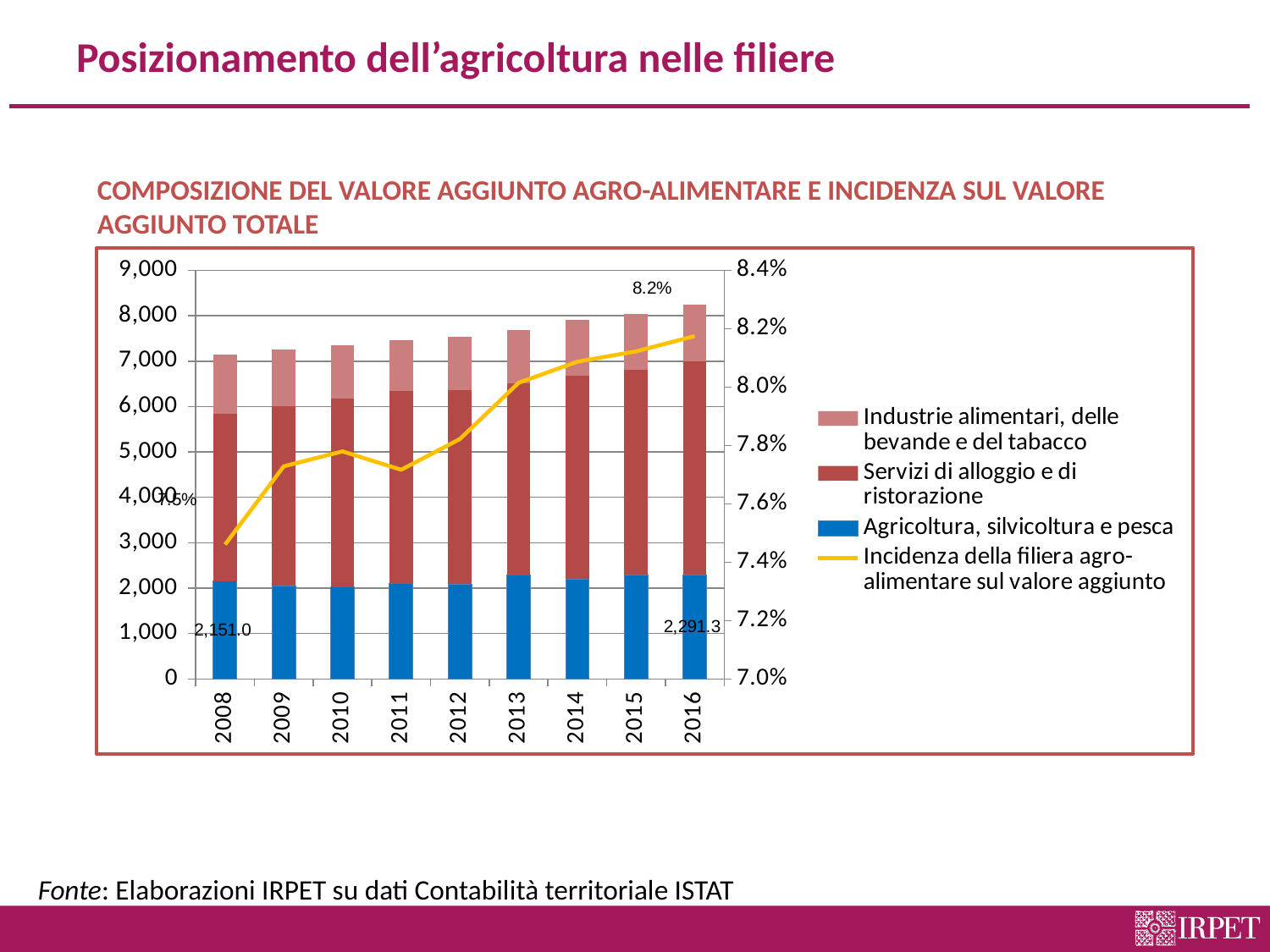
Which is larger, the Agricoltura, silvicoltura e pesca value in 2008 or in 2016? 2016 How many series does the legend list? 4 What kind of chart is this? Stacked bar chart with a line Is the total stacked bar for 2016 greater or less than 8,000? greater What is the difference between the Agricoltura, silvicoltura e pesca values in 2016 and 2008? 140.3 How many years are shown on the x axis? 9 Does the Incidenza della filiera agro-alimentare sul valore aggiunto line rise or fall overall from 2008 to 2016? Rises What is the value of Incidenza della filiera agro-alimentare sul valore aggiunto in 2016? 8.2% In which year is the Incidenza della filiera agro-alimentare sul valore aggiunto line at its lowest? 2008 What is the value of Agricoltura, silvicoltura e pesca in 2008? 2,151.0 Which year has the tallest total stacked bar? 2016 What is the value of Agricoltura, silvicoltura e pesca in 2016? 2,291.3